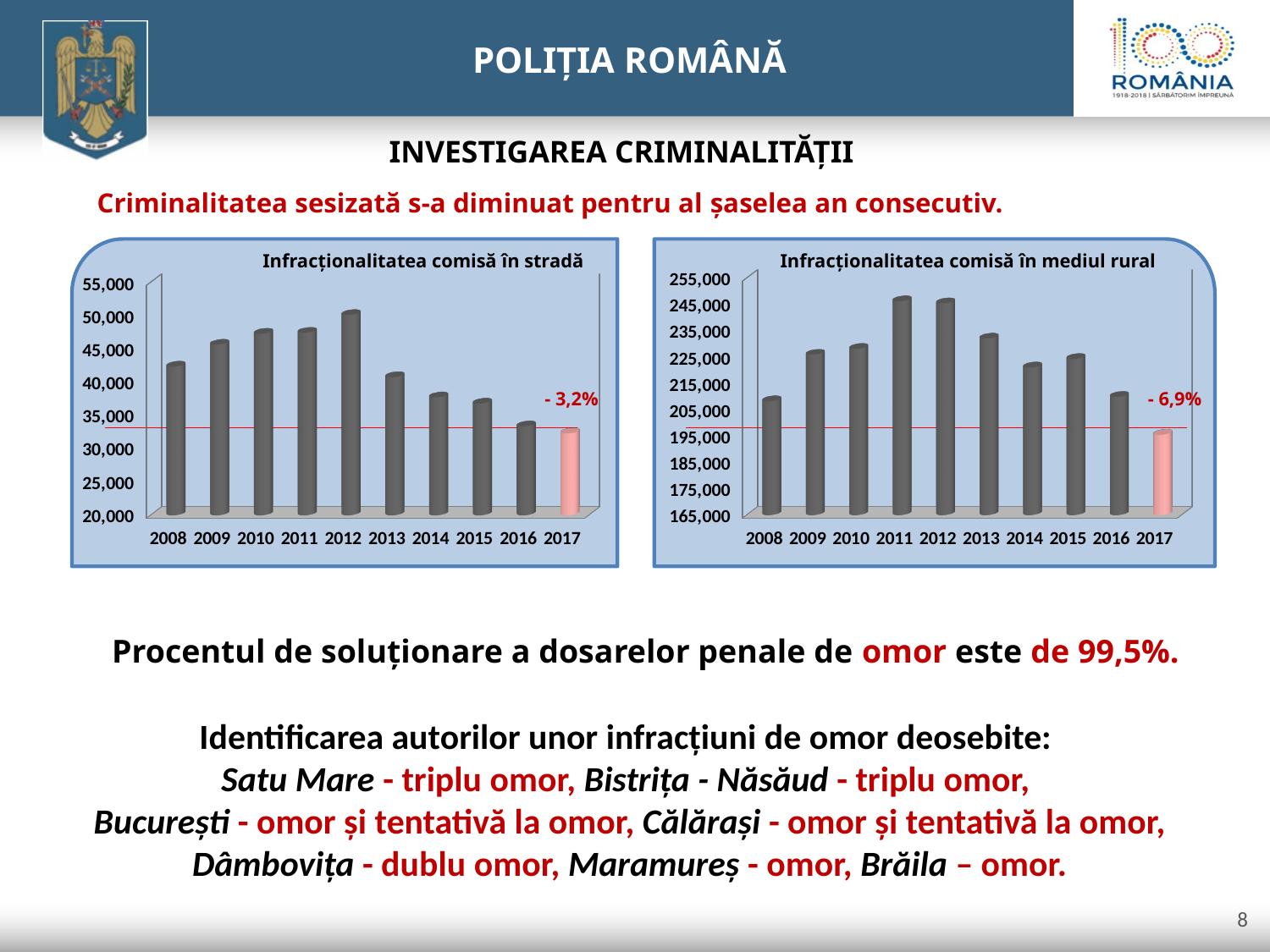
In the "Infracționalitatea comisă în mediul rural" chart, is the value for 2017 greater or less than 205,000? less In the "Infracționalitatea comisă în stradă" chart, is the value for 2017 greater or less than 35,000? less What percentage change is annotated next to the 2017 bar in the "Infracționalitatea comisă în mediul rural" chart? - 6,9% What percentage change is annotated next to the 2017 bar in the "Infracționalitatea comisă în stradă" chart? - 3,2% In the "Infracționalitatea comisă în mediul rural" chart, which is larger, the value for 2011 or the value for 2016? 2011 In the "Infracționalitatea comisă în stradă" chart, is the value for 2012 greater or less than 45,000? greater In the "Infracționalitatea comisă în stradă" chart, which is larger, the value for 2008 or the value for 2014? 2008 What kind of chart is "Infracționalitatea comisă în stradă"? Bar chart How many years are shown on the x axis of the "Infracționalitatea comisă în stradă" chart? 10 In the "Infracționalitatea comisă în stradă" chart, which year has the highest bar? 2012 In the "Infracționalitatea comisă în mediul rural" chart, which year has the lowest bar? 2017 In the "Infracționalitatea comisă în stradă" chart, which year has the lowest bar? 2017